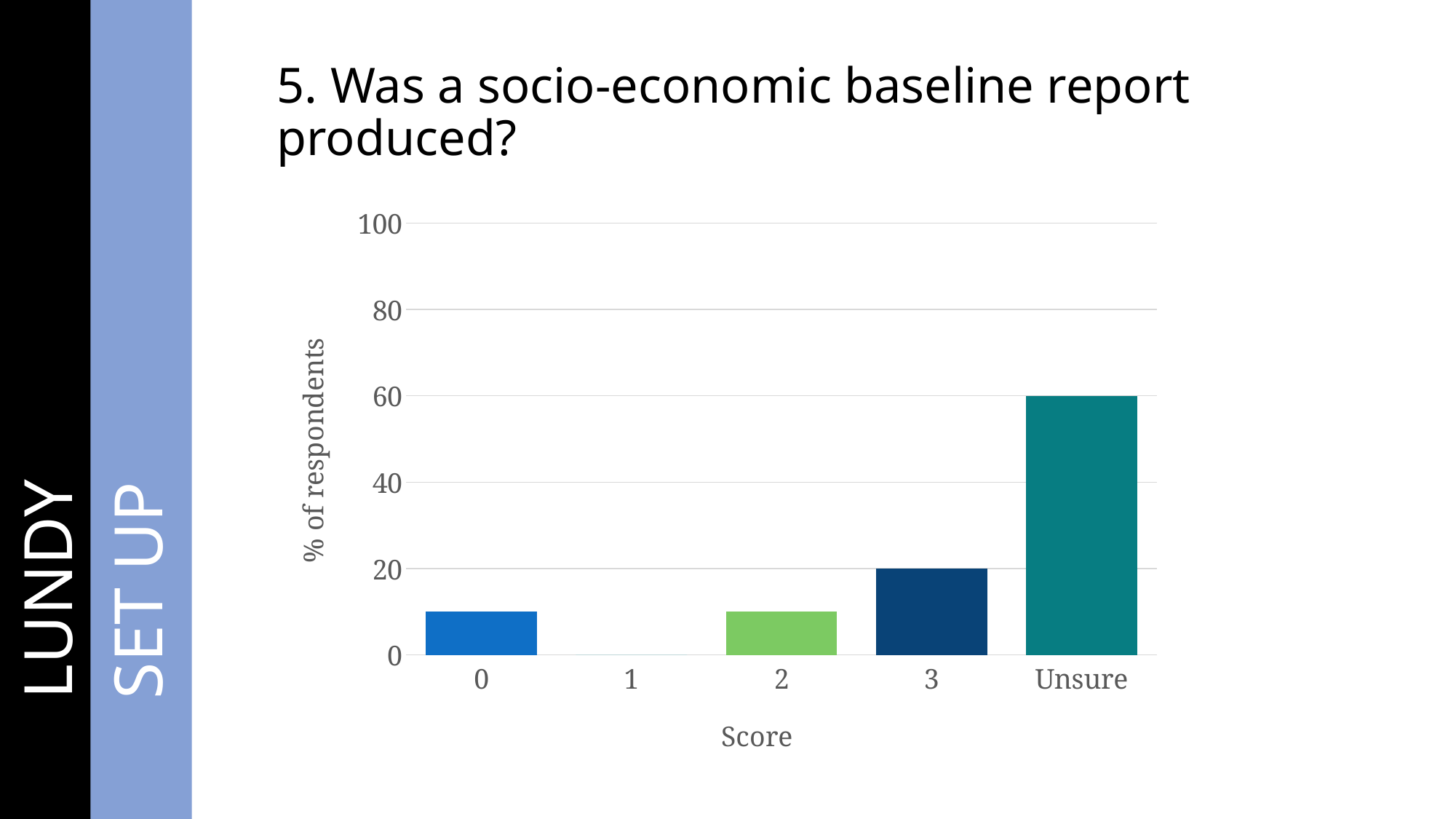
Which score category has the lowest percentage of respondents? 1 What percentage of respondents gave a score of 1? 0 How many score categories are shown on the x axis? 5 What is the label on the vertical axis? % of respondents What is the difference in percentage of respondents between Unsure and score 3? 40 Which score category has the highest percentage of respondents? Unsure What percentage of respondents answered Unsure? 60 Which has a larger percentage of respondents, score 3 or score 0? 3 Is the value for score 2 greater or less than 20? less Is the value for score 0 greater or less than 20? less What percentage of respondents gave a score of 3? 20 What kind of chart is shown on the slide? bar chart